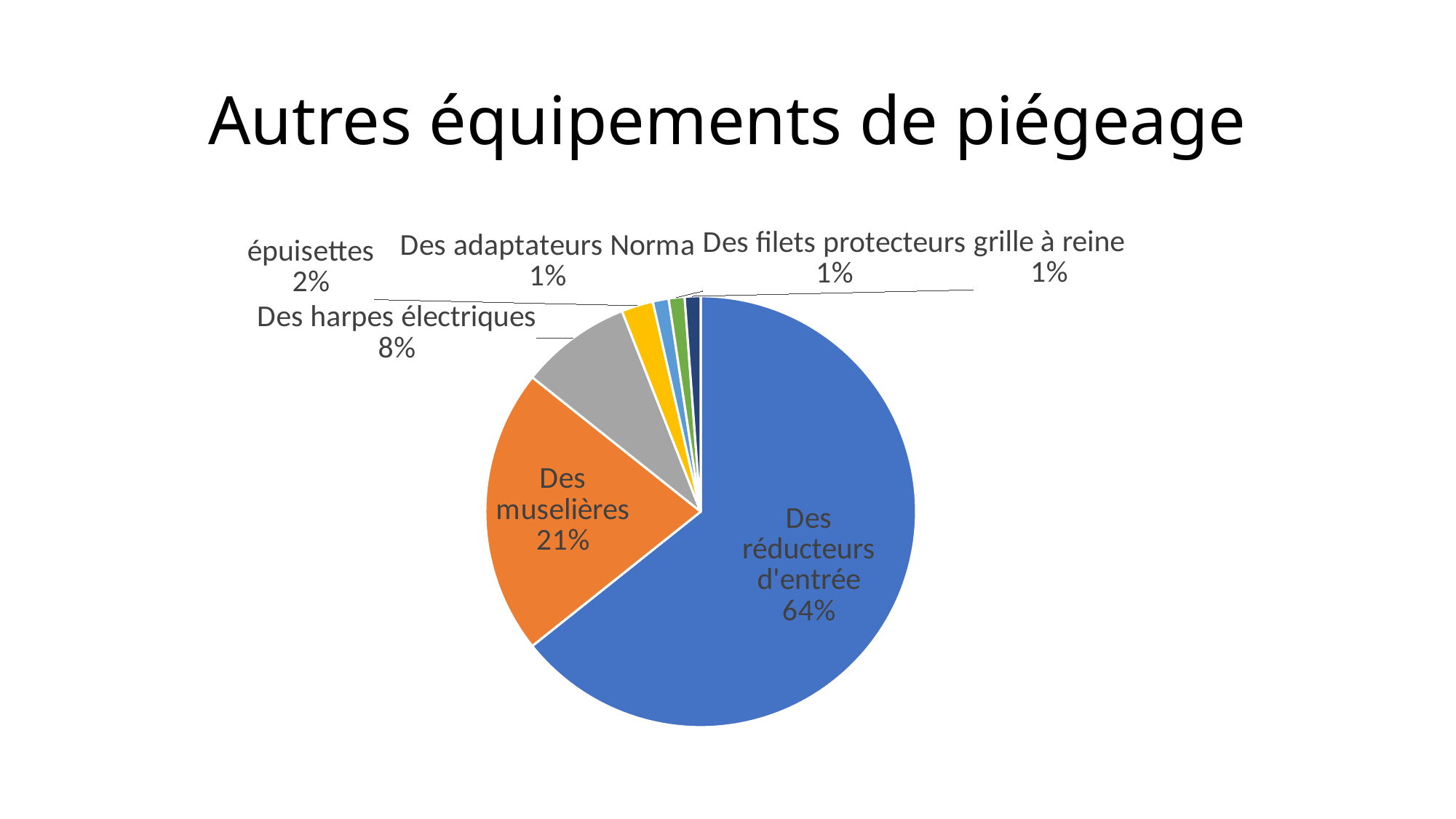
What share of the pie is 'épuisettes'? 2% What colour is the slice for 'Des muselières'? orange Which is larger, the slice for 'Des harpes électriques' or the slice for 'épuisettes'? Des harpes électriques How many labelled categories does the pie chart have? 7 What share of the pie is 'Des réducteurs d'entrée'? 64% What share of the pie is 'Des harpes électriques'? 8% What is the difference in percentage points between 'Des réducteurs d'entrée' and 'Des muselières'? 43 What is the title of the chart on the slide? Autres équipements de piégeage What kind of chart is shown on the slide? pie chart Which category has the largest slice of the pie? Des réducteurs d'entrée